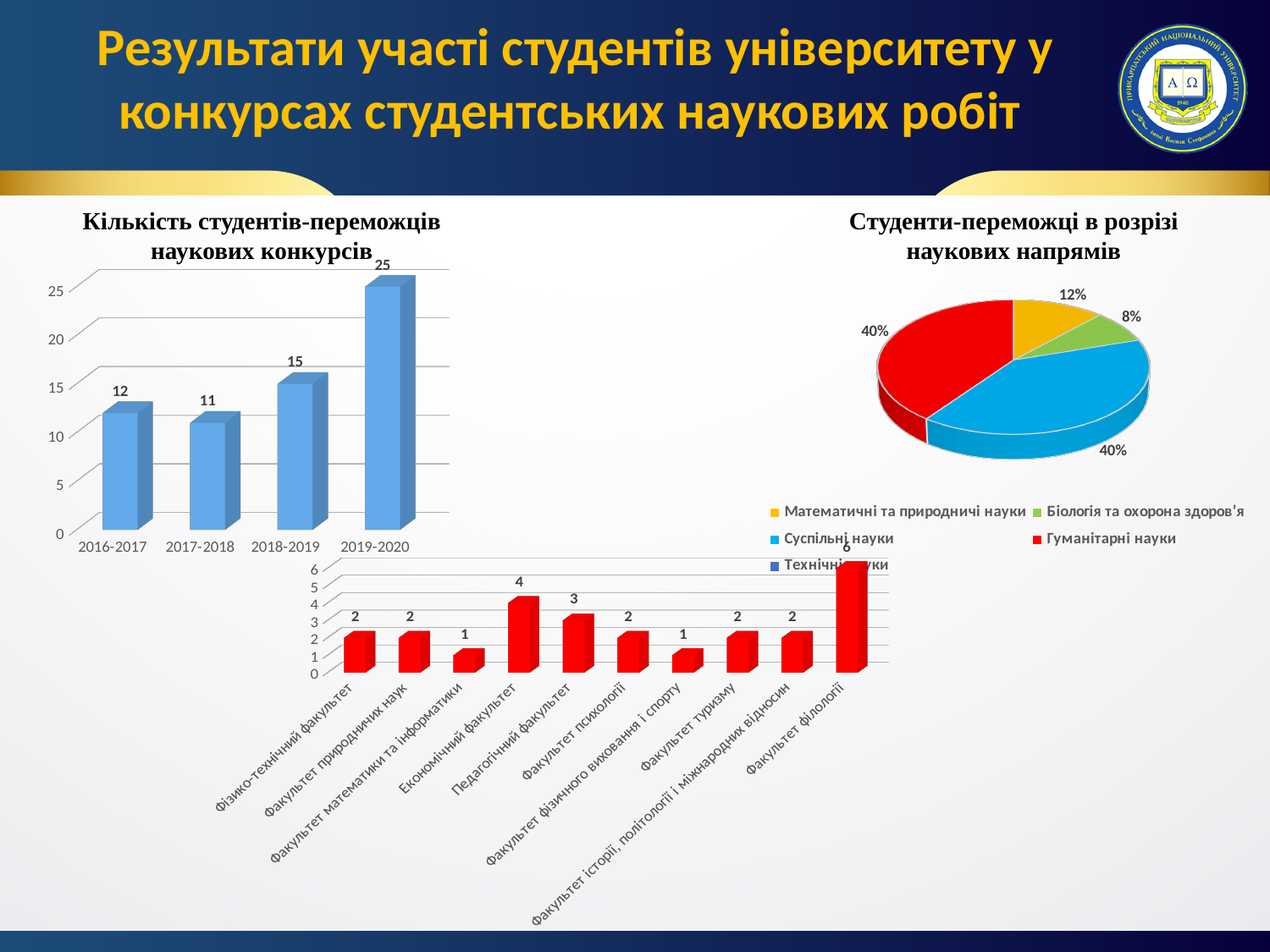
In the pie chart 'Студенти-переможці в розрізі наукових напрямів', what share does 'Біологія та охорона здоров’я' have? 8% In the bottom chart showing faculties, what is the value for 'Економічний факультет'? 4 In the pie chart 'Студенти-переможці в розрізі наукових напрямів', what share does 'Математичні та природничі науки' have? 12% In the chart 'Кількість студентів-переможців наукових конкурсів', how many years are shown on the x axis? 4 How many entries does the legend of the pie chart 'Студенти-переможці в розрізі наукових напрямів' list? 5 In the chart 'Кількість студентів-переможців наукових конкурсів', which year has the lowest value? 2017-2018 In the chart 'Кількість студентів-переможців наукових конкурсів', what is the difference between the values for 2019-2020 and 2018-2019? 10 In the chart 'Кількість студентів-переможців наукових конкурсів', what is the value for 2019-2020? 25 In the bottom chart showing faculties, which faculty has the highest value? Факультет філології In the bottom chart showing faculties, which is larger: the value for 'Педагогічний факультет' or the value for 'Факультет психології'? Педагогічний факультет What kind of chart is the chart at the bottom of the slide showing faculties? bar chart In the chart 'Кількість студентів-переможців наукових конкурсів', is the value for 2016-2017 greater or less than 10? greater